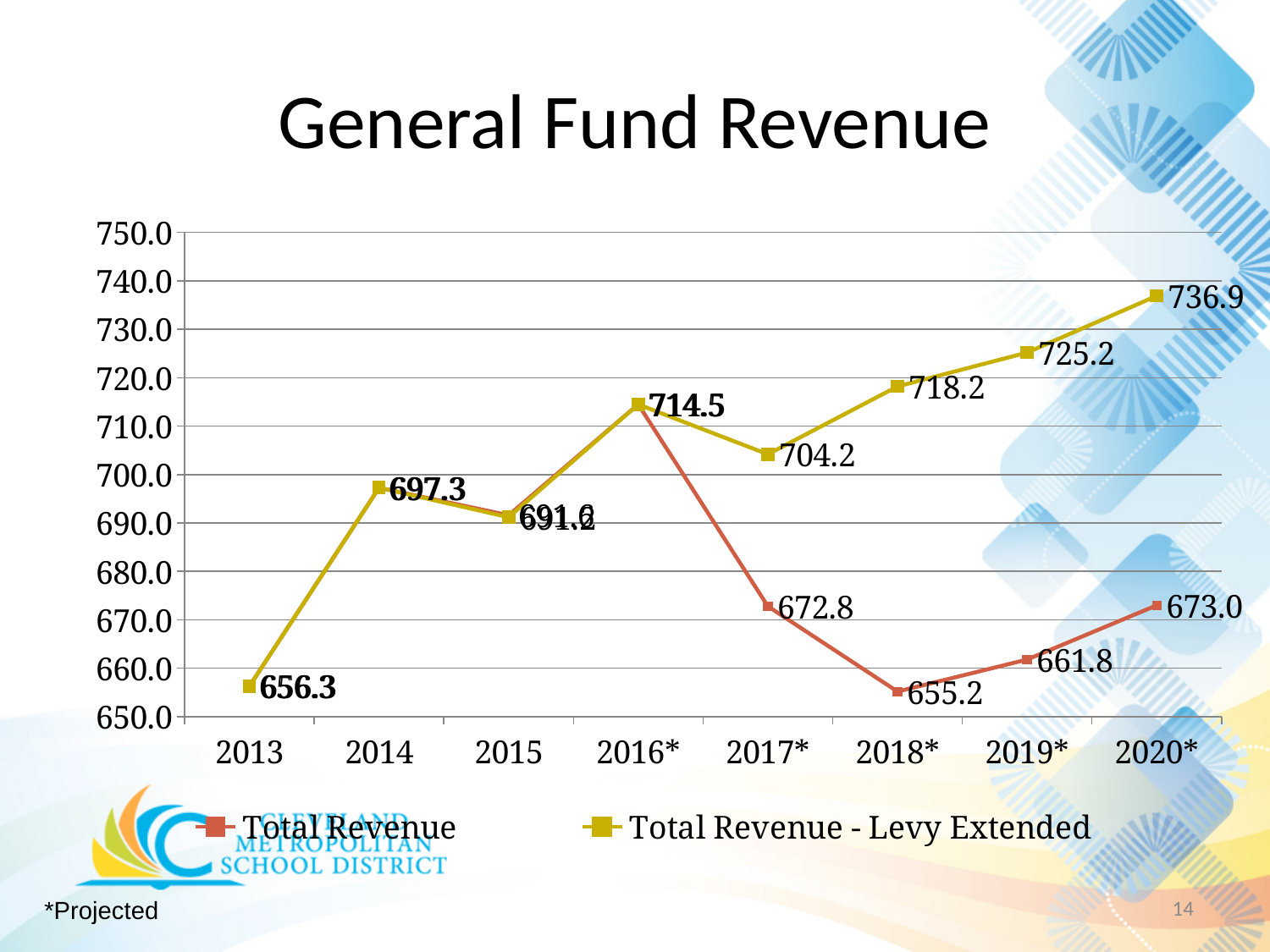
What kind of chart is shown on the slide? line chart How many years are shown on the x axis? 8 What is the value of Total Revenue in 2018*? 655.2 How many series does the legend list? 2 What is the value of Total Revenue - Levy Extended in 2020*? 736.9 Which is larger in 2019*: Total Revenue or Total Revenue - Levy Extended? Total Revenue - Levy Extended What is the difference between Total Revenue - Levy Extended and Total Revenue in 2020*? 63.9 Does Total Revenue - Levy Extended rise or fall from 2017* to 2020*? rise In which year is Total Revenue at its lowest? 2018* What is the value shown for 2013? 656.3 In which year does Total Revenue - Levy Extended reach its highest value? 2020* What is the value of Total Revenue - Levy Extended in 2017*? 704.2